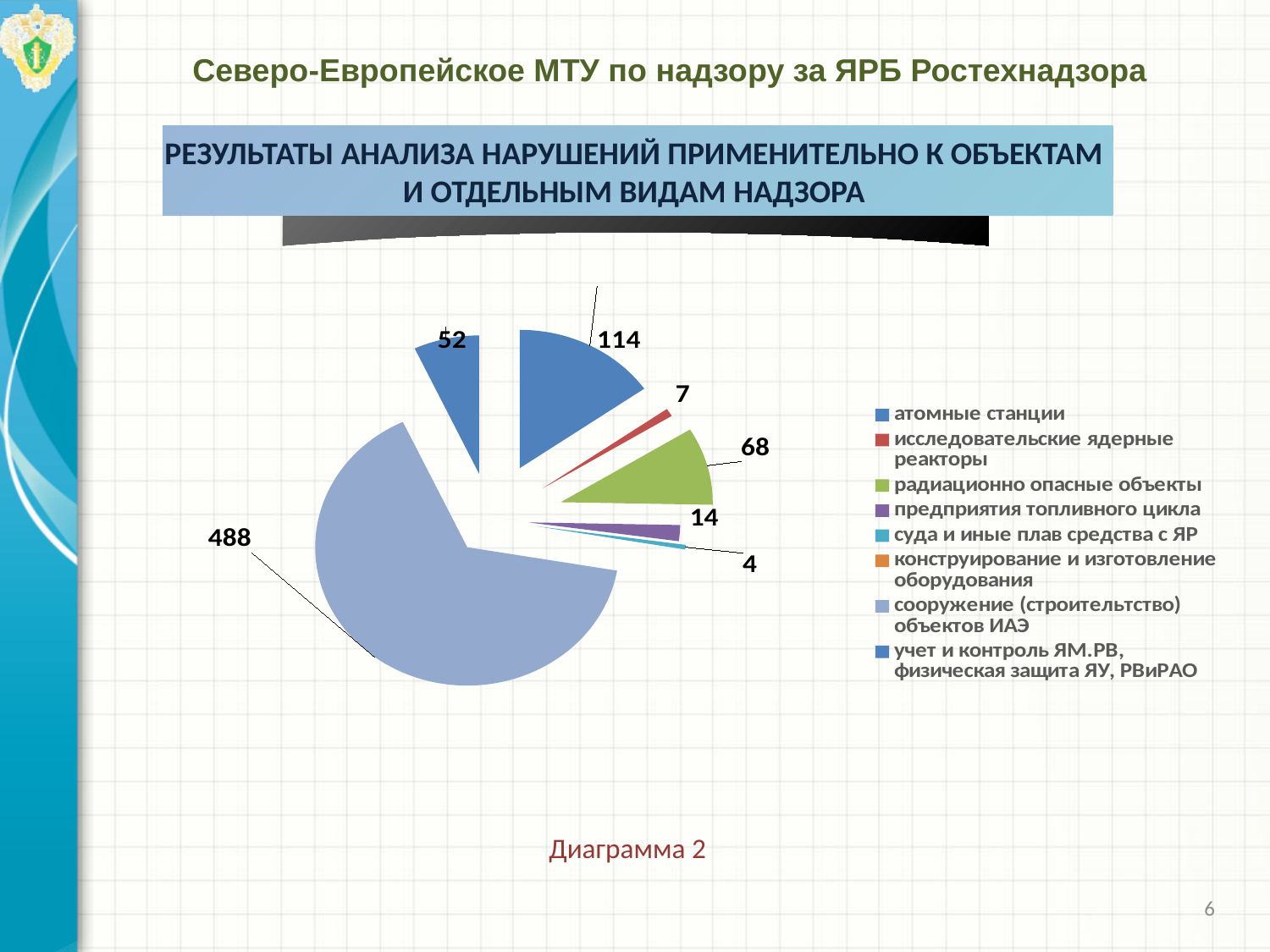
What value is shown for the slice "атомные станции"? 114 What value is shown for the slice "предприятия топливного цикла"? 14 What value is shown for the slice "сооружение (строительство) объектов ИАЭ"? 488 What value is shown for the slice "исследовательские ядерные реакторы"? 7 What is the difference between the values for "атомные станции" and "учет и контроль ЯМ.РВ, физическая защита ЯУ, РВиРАО"? 62 What kind of chart is shown on the slide? pie chart What caption appears below the chart? Диаграмма 2 What value is shown for the slice "радиационно опасные объекты"? 68 How many categories are listed in the chart's legend? 8 Which category has the largest slice in the pie chart? сооружение (строительство) объектов ИАЭ What value is shown for the slice "учет и контроль ЯМ.РВ, физическая защита ЯУ, РВиРАО"? 52 Which is larger: the value for "атомные станции" or for "радиационно опасные объекты"? атомные станции